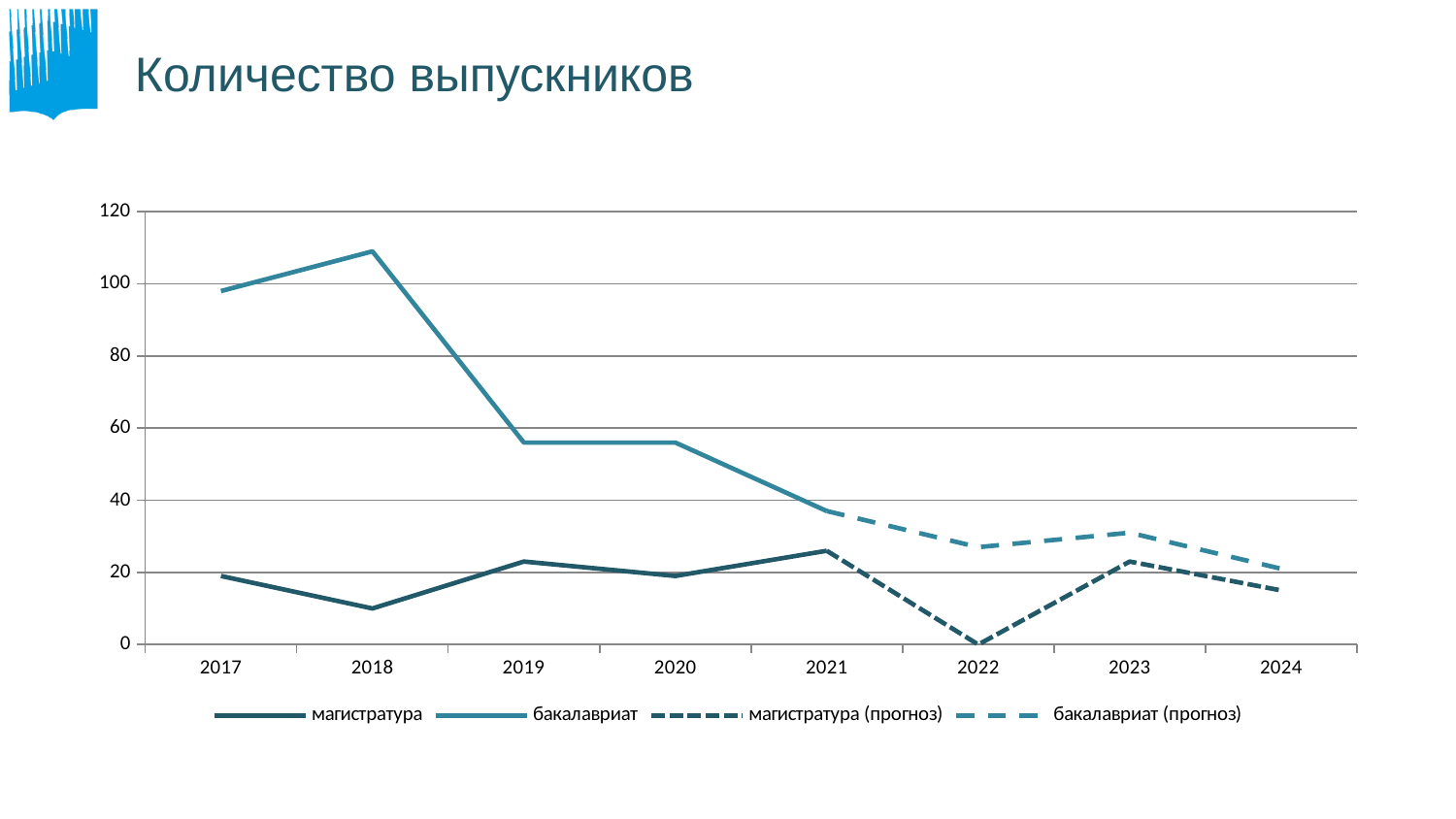
Does the бакалавриат line rise or fall from 2018 to 2021? fall Which is larger in 2019, бакалавриат or магистратура? бакалавриат How many years are shown on the x axis? 8 In which year does the бакалавриат line reach its highest value? 2018 Is the value for бакалавриат (прогноз) in 2024 greater or less than 40? less In which year does the solid магистратура line reach its lowest value? 2018 Is the value for бакалавриат in 2018 greater or less than 100? greater What kind of chart is shown on the slide? line chart What is the title of the chart? Количество выпускников How many series does the legend list? 4 Is the value for бакалавриат in 2019 greater or less than 60? less